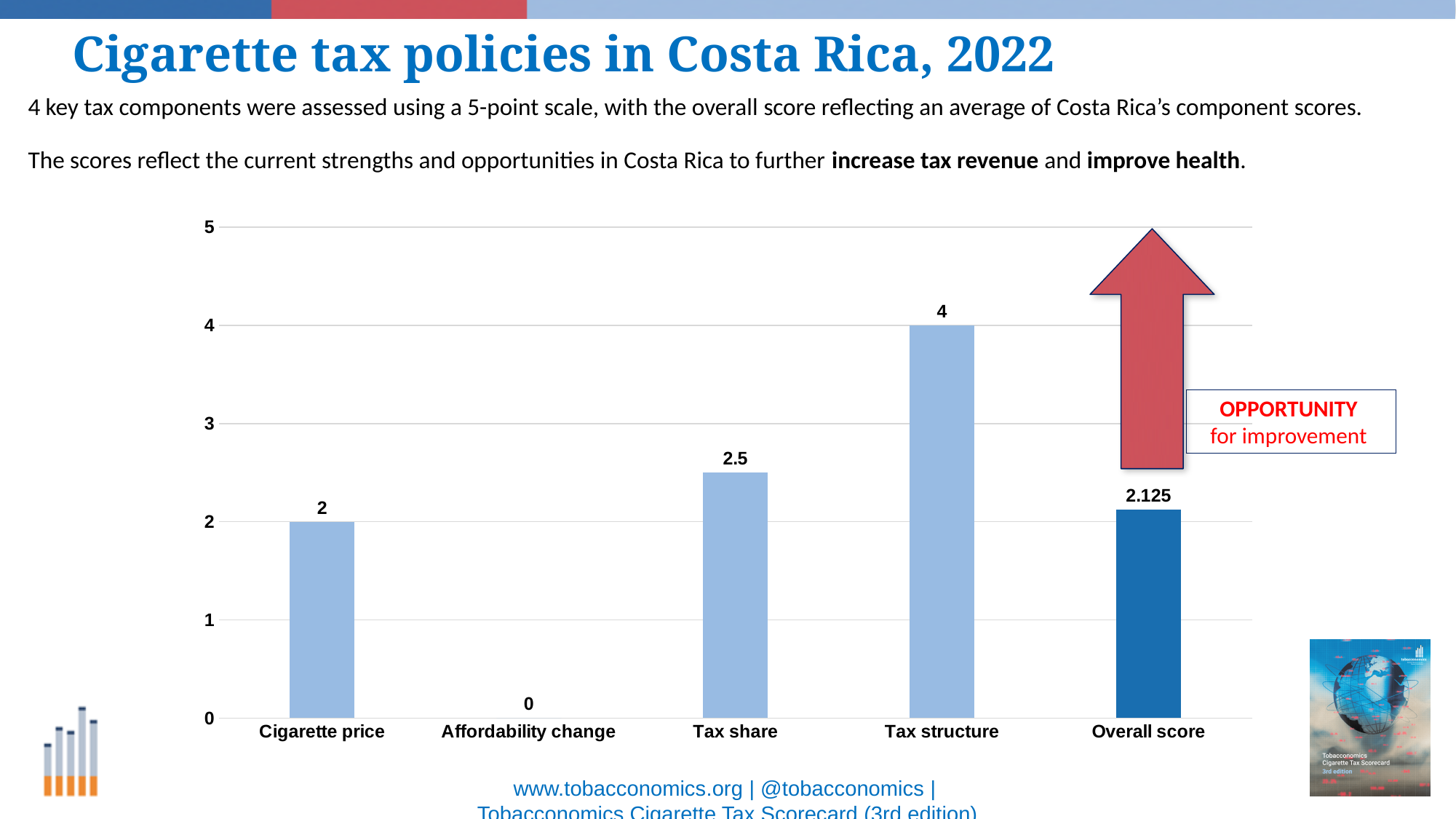
What kind of chart is shown on the slide? Bar chart Which category has the lowest value? Affordability change What is the value for Tax share? 2.5 Which category has the highest value? Tax structure What is the Overall score? 2.125 Which is larger, the value for Tax share or the value for Cigarette price? Tax share What is the value for Cigarette price? 2 What is the value for Affordability change? 0 What is the difference between the values for Tax structure and Tax share? 1.5 What is the value for Tax structure? 4 How many categories are shown on the x axis? 5 What is the maximum value shown on the y axis? 5